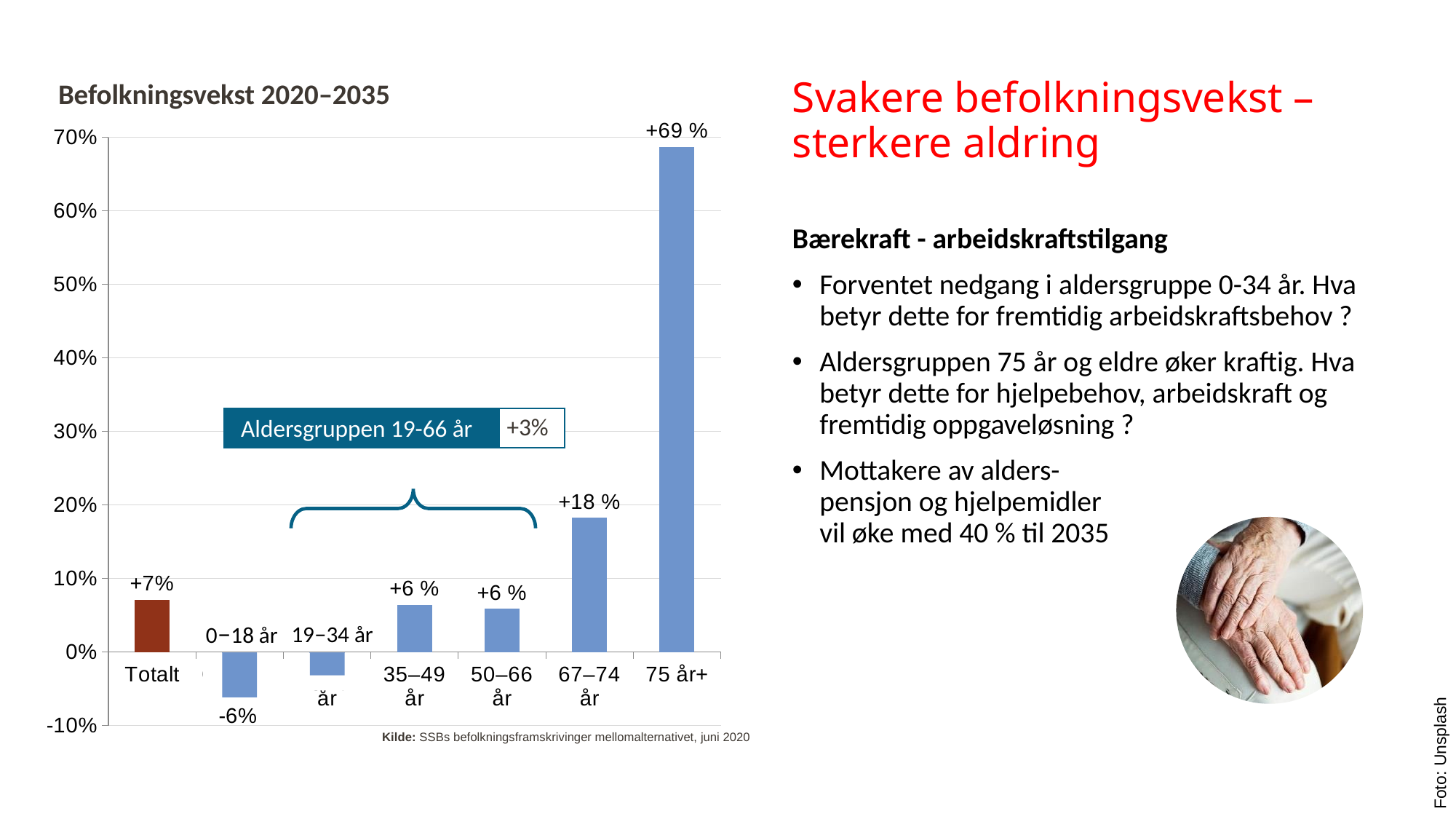
How many categories are shown on the x axis of the chart? 7 What is the value for Totalt in the chart? +7% What is the title of the chart? Befolkningsvekst 2020–2035 What is the value for 67–74 år in the chart? +18 % What is the difference between the values for 75 år+ and 67–74 år? 51 percentage points Which age group has the highest population growth in the chart? 75 år+ What is the value for 75 år+ in the Befolkningsvekst 2020–2035 chart? +69 % What is the value for 0–18 år in the chart? -6% What kind of chart is shown on the slide? Bar chart Is the value for 19–34 år greater or less than 0%? less Which category has the lowest value in the chart? 0–18 år Which is larger, the value for 67–74 år or the value for 35–49 år? 67–74 år